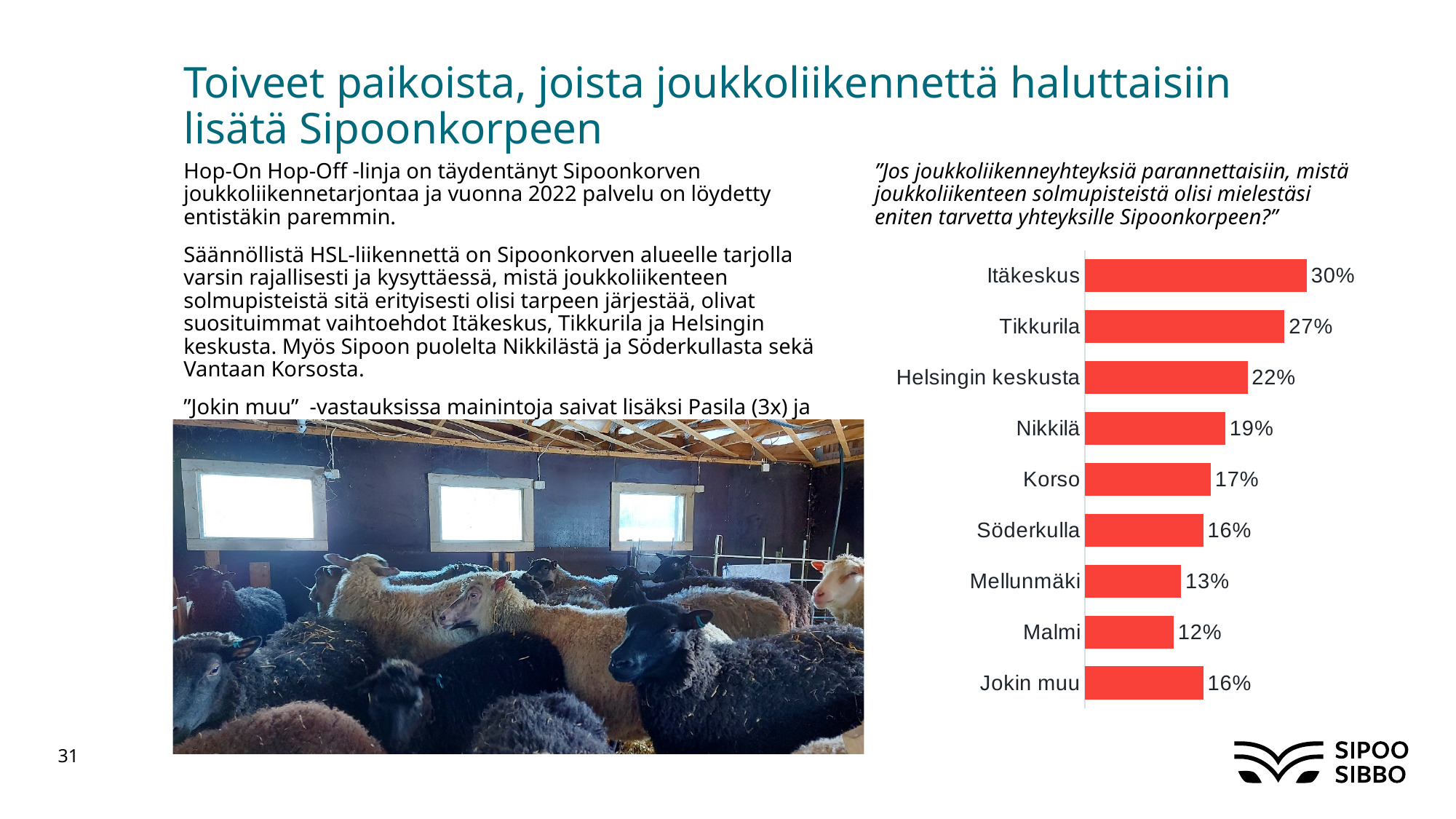
Which category has the lowest value in the chart? Malmi What type of chart is shown on the slide? Bar chart How many categories are shown in the bar chart? 9 What percentage of respondents chose Itäkeskus? 30% What colour are the bars in the chart? Red Which category has the highest value in the chart? Itäkeskus What is the difference between the values for Itäkeskus and Tikkurila? 3% What is the difference between the values for Helsingin keskusta and Korso? 5% What percentage is shown for Mellunmäki? 13% What is the value shown for Nikkilä? 19% Which has a larger value, Korso or Malmi? Korso Which has a larger value, Tikkurila or Helsingin keskusta? Tikkurila